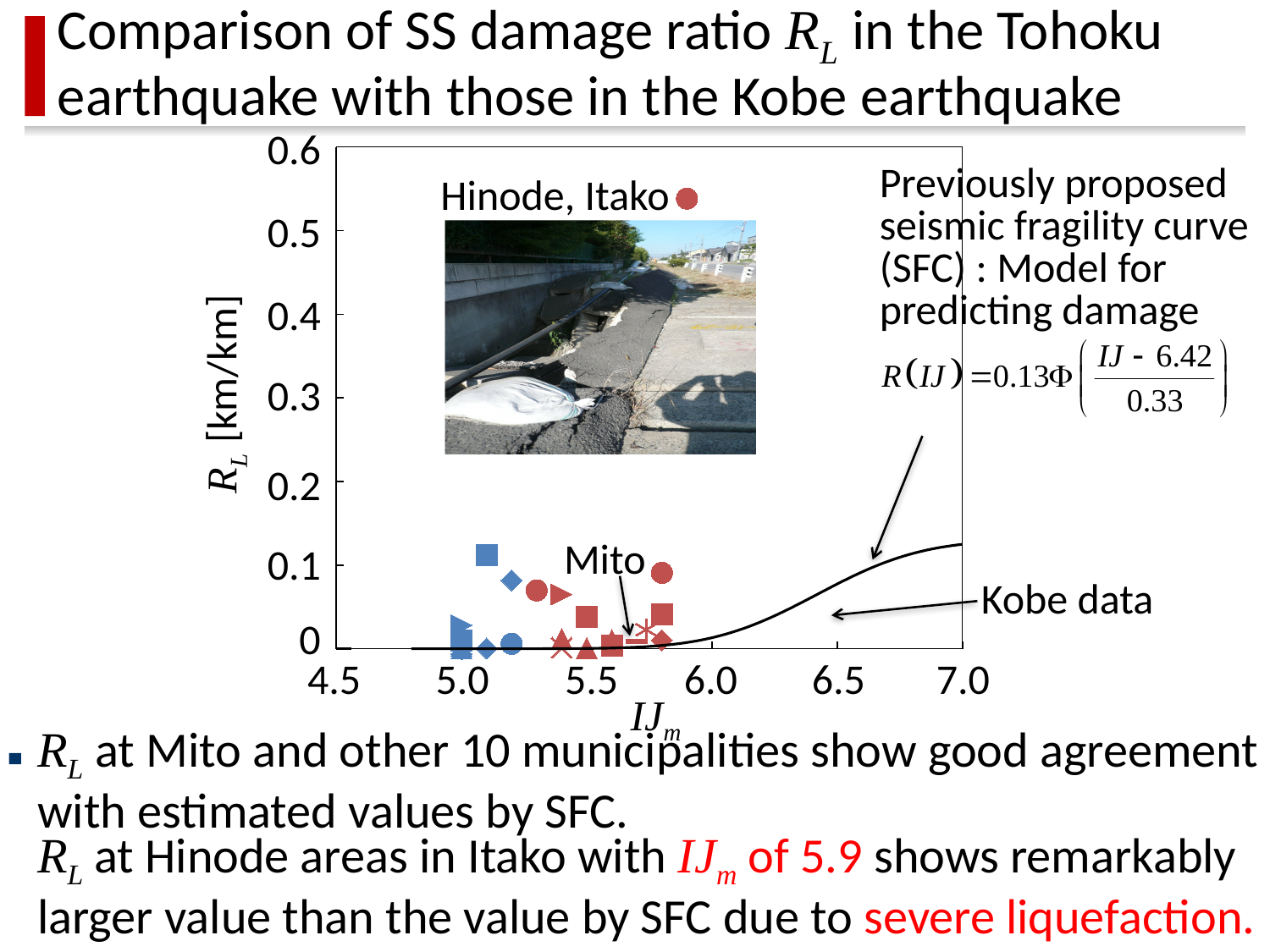
What kind of chart is shown on the slide? scatter chart Is the R_L value for the Hinode, Itako point greater or less than 0.5? greater Is the R_L value for the Hinode, Itako point greater or less than 0.6? less Which labeled point has the higher R_L value, Hinode, Itako or Mito? Hinode, Itako What is the label of the y-axis? R_L [km/km] Does the Kobe data curve rise or fall as IJ_m increases from 6.0 to 7.0? rise Is the IJ_m value for the Mito point greater or less than 6.0? less What is the label of the x-axis? IJ_m Which labeled point has the highest R_L value on the chart? Hinode, Itako